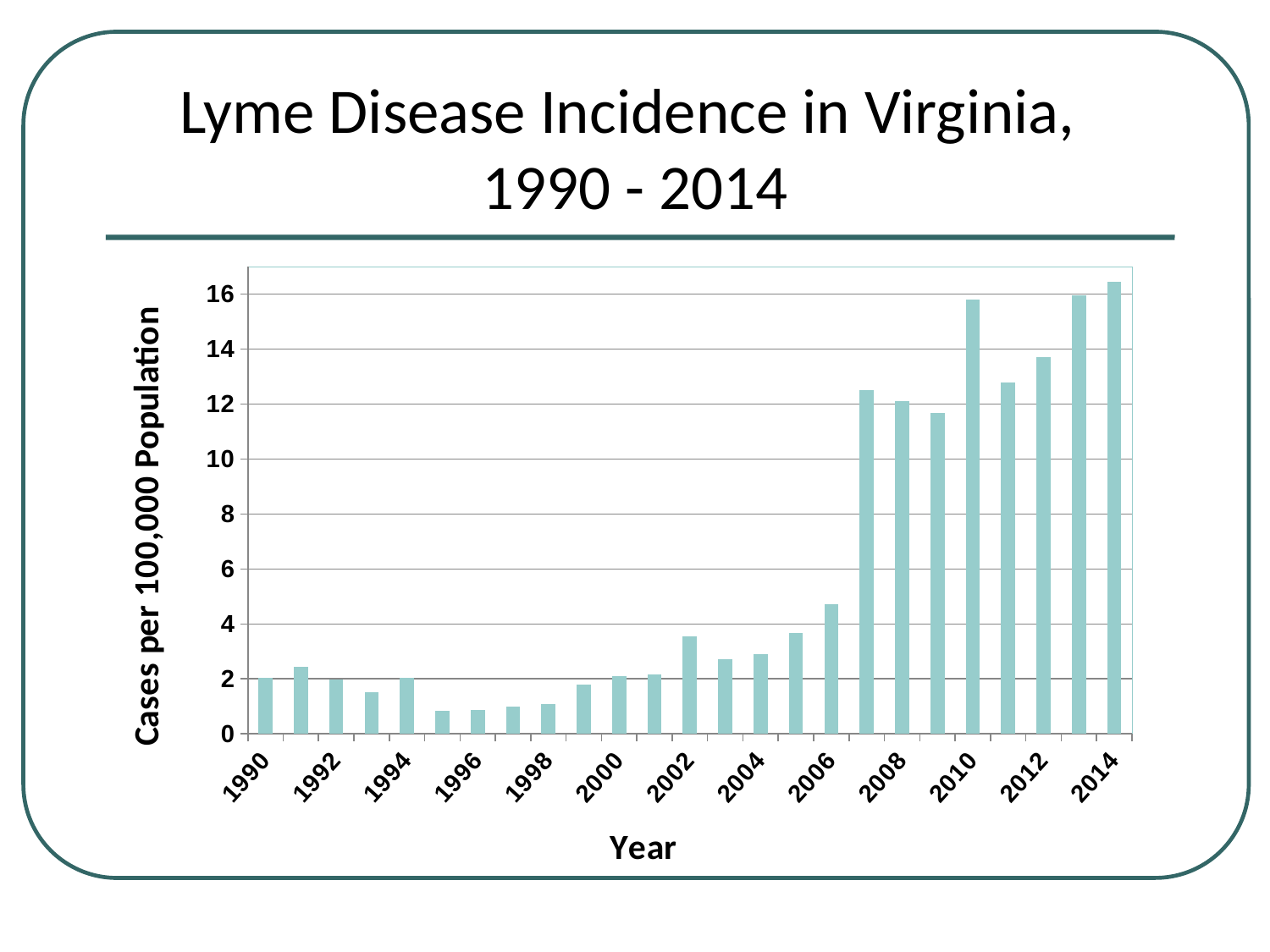
Is the value for 2009 greater or less than 12? less Which year has the larger value, 2006 or 2008? 2008 Is the value for 2014 greater or less than 16? greater Overall, do the values rise or fall from 1990 to 2014? rise Is the value for 1996 greater or less than 2? less Which year has the highest incidence in the chart? 2014 What is the label of the vertical axis? Cases per 100,000 Population How many bars (years) are plotted in the chart? 25 Which year has the larger value, 2010 or 2012? 2010 What kind of chart is shown on the slide? bar chart